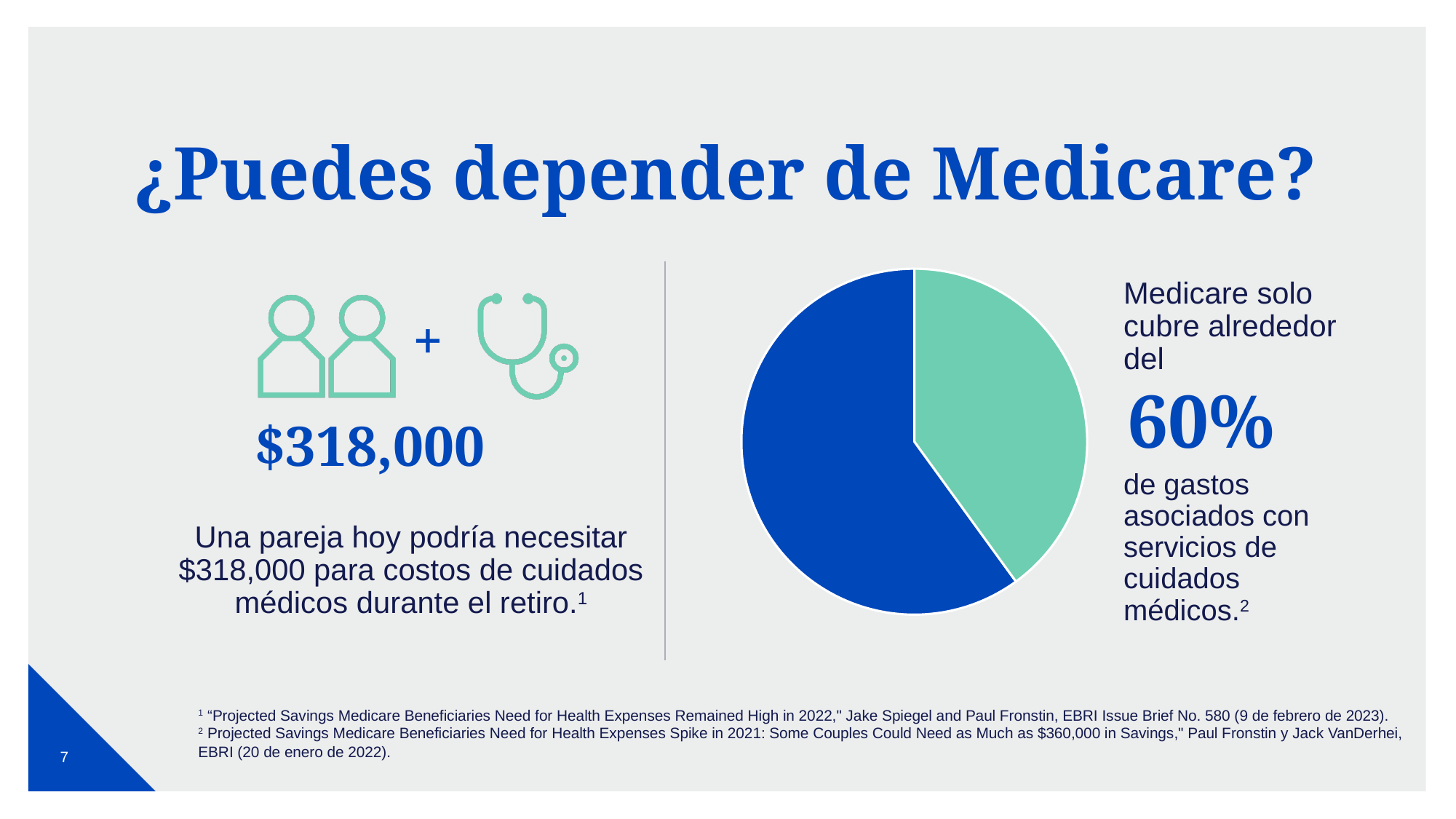
What kind of chart is shown on the slide? pie chart Is the teal slice of the pie chart greater or less than 50% of the pie? less How many slices does the pie chart have? 2 What two colours are used for the slices of the pie chart? dark blue and teal Which slice of the pie chart is the smallest? teal Which slice of the pie chart is larger, the dark blue one or the teal one? dark blue Is the dark blue slice of the pie chart greater or less than 50% of the pie? greater According to the text next to the pie chart, what share of medical care expenses does Medicare cover? 60% Does the pie chart have a legend? No